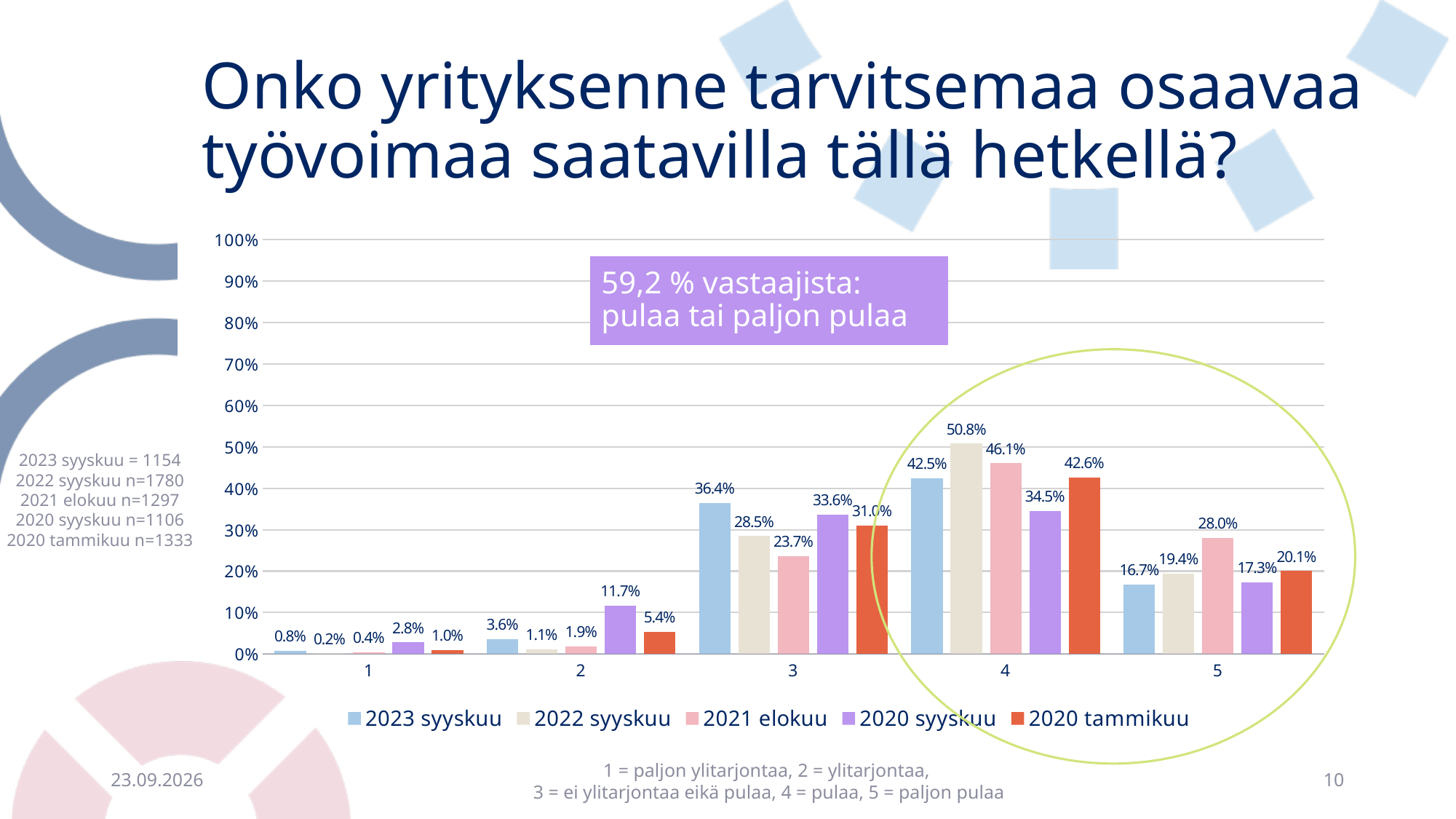
How many categories are shown on the x axis? 5 What is the value for category 2 in the 2020 syyskuu series? 11.7% What is the difference between the 2022 syyskuu and 2023 syyskuu values for category 4? 8.3% What kind of chart is shown on the slide? bar chart What is the value for category 4 in the 2022 syyskuu series? 50.8% What is the value for category 5 in the 2021 elokuu series? 28.0% For category 3, which is larger: the 2020 syyskuu value or the 2021 elokuu value? 2020 syyskuu Is the value for category 4 in the 2022 syyskuu series greater or less than 50%? greater Which category has the highest value in the 2020 tammikuu series? 4 Which series has the lowest value for category 1? 2022 syyskuu What is the value for category 3 in the 2023 syyskuu series? 36.4% How many series does the legend list? 5